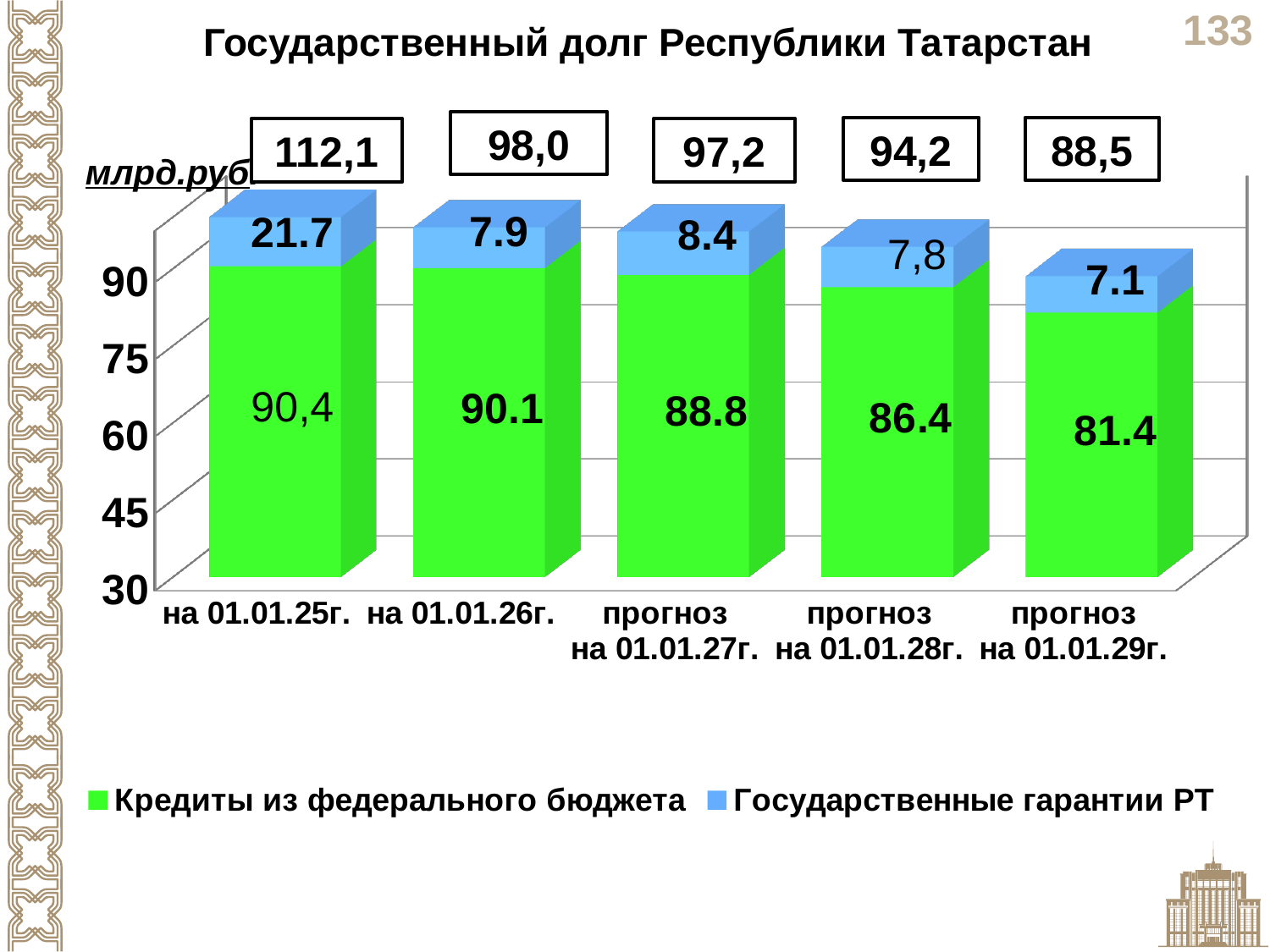
What is the value of Кредиты из федерального бюджета for на 01.01.25г.? 90,4 What is the value of Государственные гарантии РТ for на 01.01.26г.? 7.9 What is the value of Кредиты из федерального бюджета for прогноз на 01.01.29г.? 81.4 Which is larger: Кредиты из федерального бюджета for прогноз на 01.01.27г. or for прогноз на 01.01.28г.? прогноз на 01.01.27г. Which category has the highest value for Государственные гарантии РТ? на 01.01.25г. What is the total state debt shown above the bar for на 01.01.25г.? 112,1 What type of chart is shown on the slide? bar chart How many series does the legend list? 2 How many categories are shown on the x axis? 5 Which category has the lowest value for Кредиты из федерального бюджета? прогноз на 01.01.29г. What is the difference between the Государственные гарантии РТ values for на 01.01.25г. and на 01.01.26г.? 13.8 What is the total state debt shown above the bar for прогноз на 01.01.27г.? 97,2